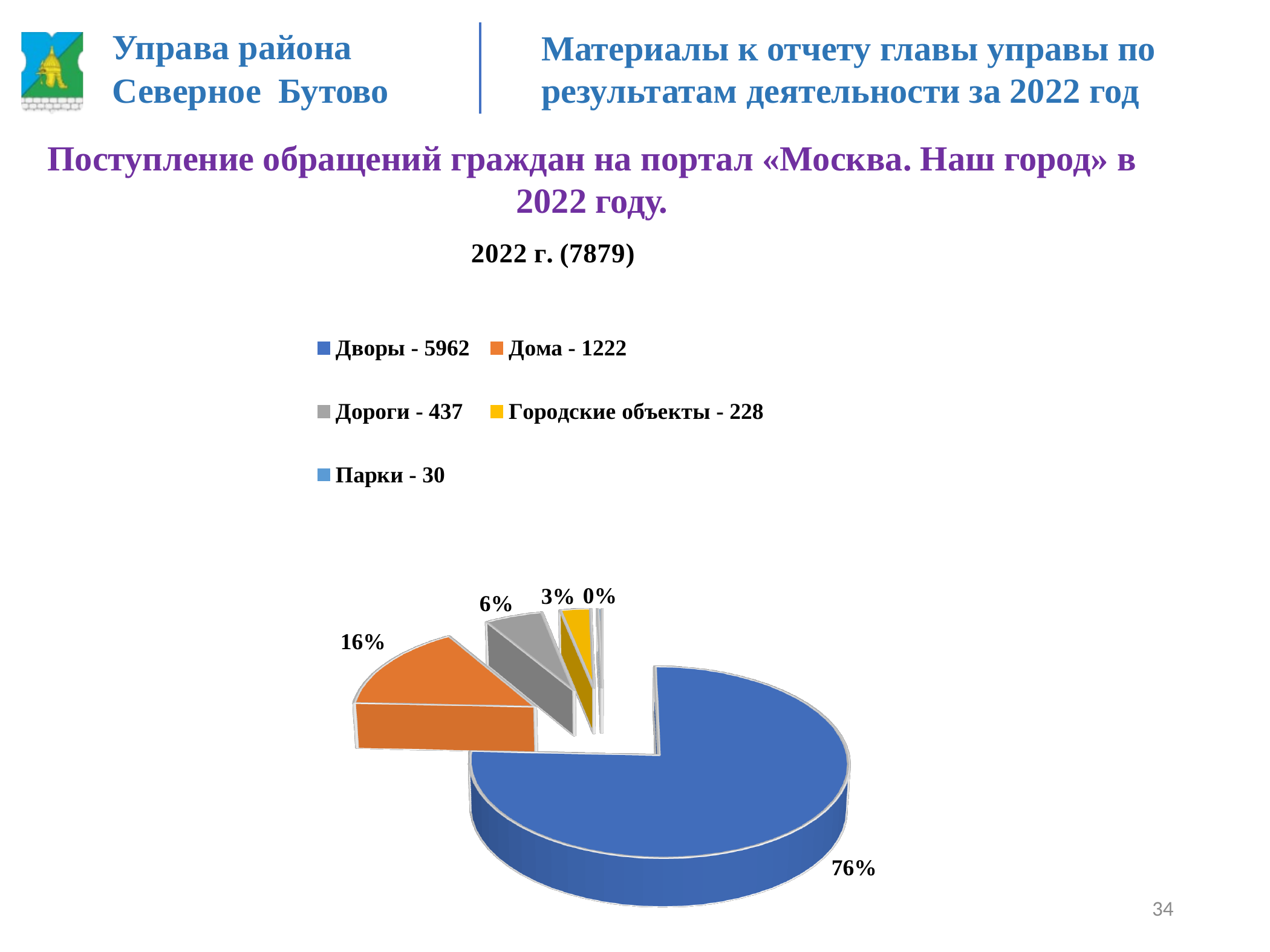
How many categories does the pie chart have? 5 What kind of chart is shown on the slide? pie chart What share of the pie does Дома represent? 16% What is the value for Городские объекты? 228 What is the chart's title? 2022 г. (7879) Which is larger, the value for Дороги or the value for Городские объекты? Дороги What is the value for Дома? 1222 Which category has the lowest value? Парки What share of the pie does Дороги represent? 6% What is the value for Дворы? 5962 Which category has the highest value? Дворы What is the difference between the values for Дома and Дороги? 785